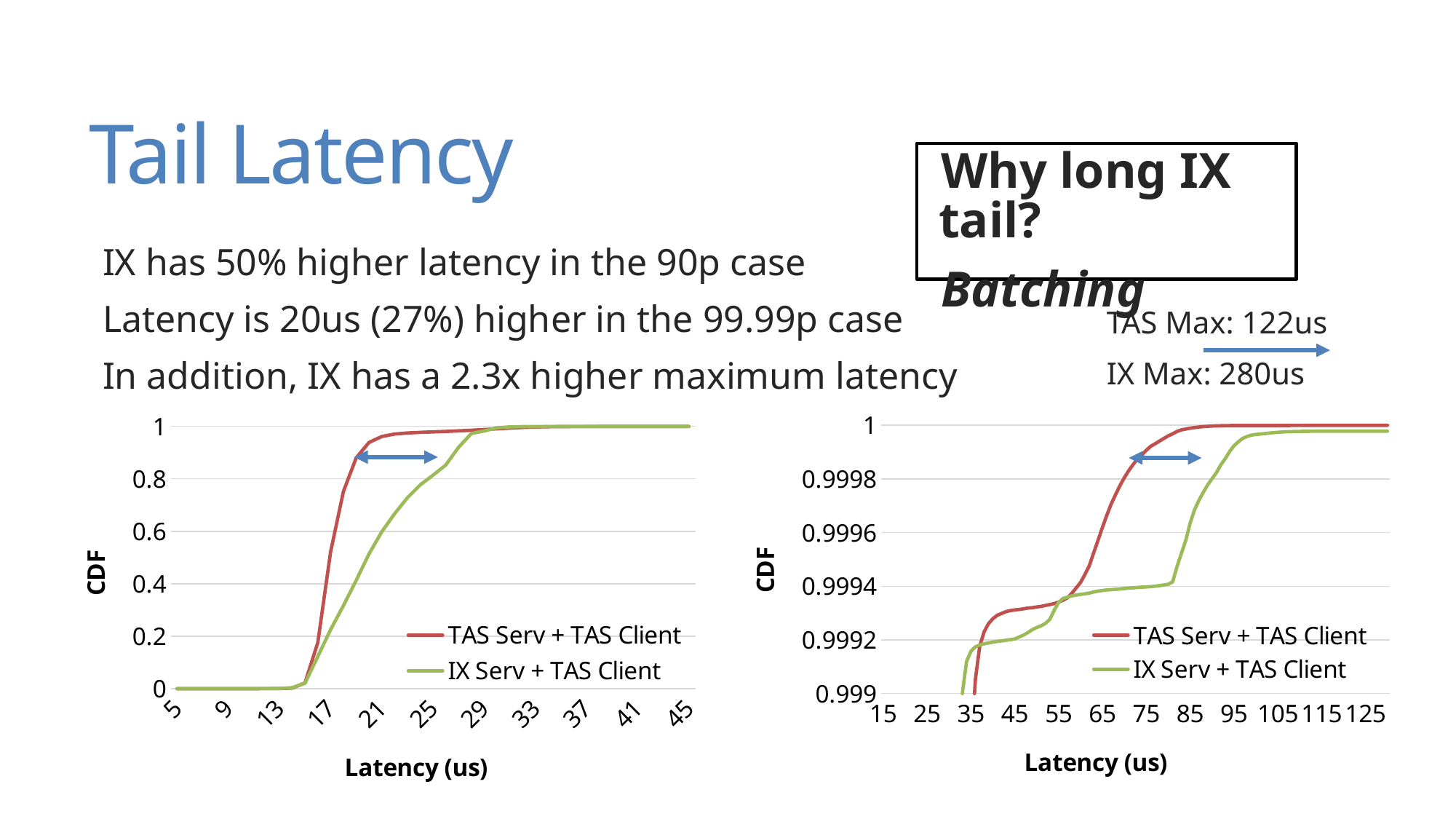
In the left chart, at a latency of 21 us, which series has the higher CDF value? TAS Serv + TAS Client In the left chart, which series is drawn in green? IX Serv + TAS Client In the left chart, does the CDF for IX Serv + TAS Client rise or fall as latency increases? rise In the left chart, is the CDF value for TAS Serv + TAS Client at a latency of 21 us greater or less than 0.8? greater How many tick labels are shown on the x axis of the right chart? 12 In the right chart, at a latency of 75 us, which series has the higher CDF value? TAS Serv + TAS Client How many series does the legend of the right chart list? 2 What is the x-axis label of the right chart? Latency (us) In the right chart, is the CDF value for TAS Serv + TAS Client at a latency of 85 us greater or less than 0.9998? greater What kind of chart is the left chart on the slide? line chart In the right chart, is the CDF value for IX Serv + TAS Client at a latency of 75 us greater or less than 0.9996? less